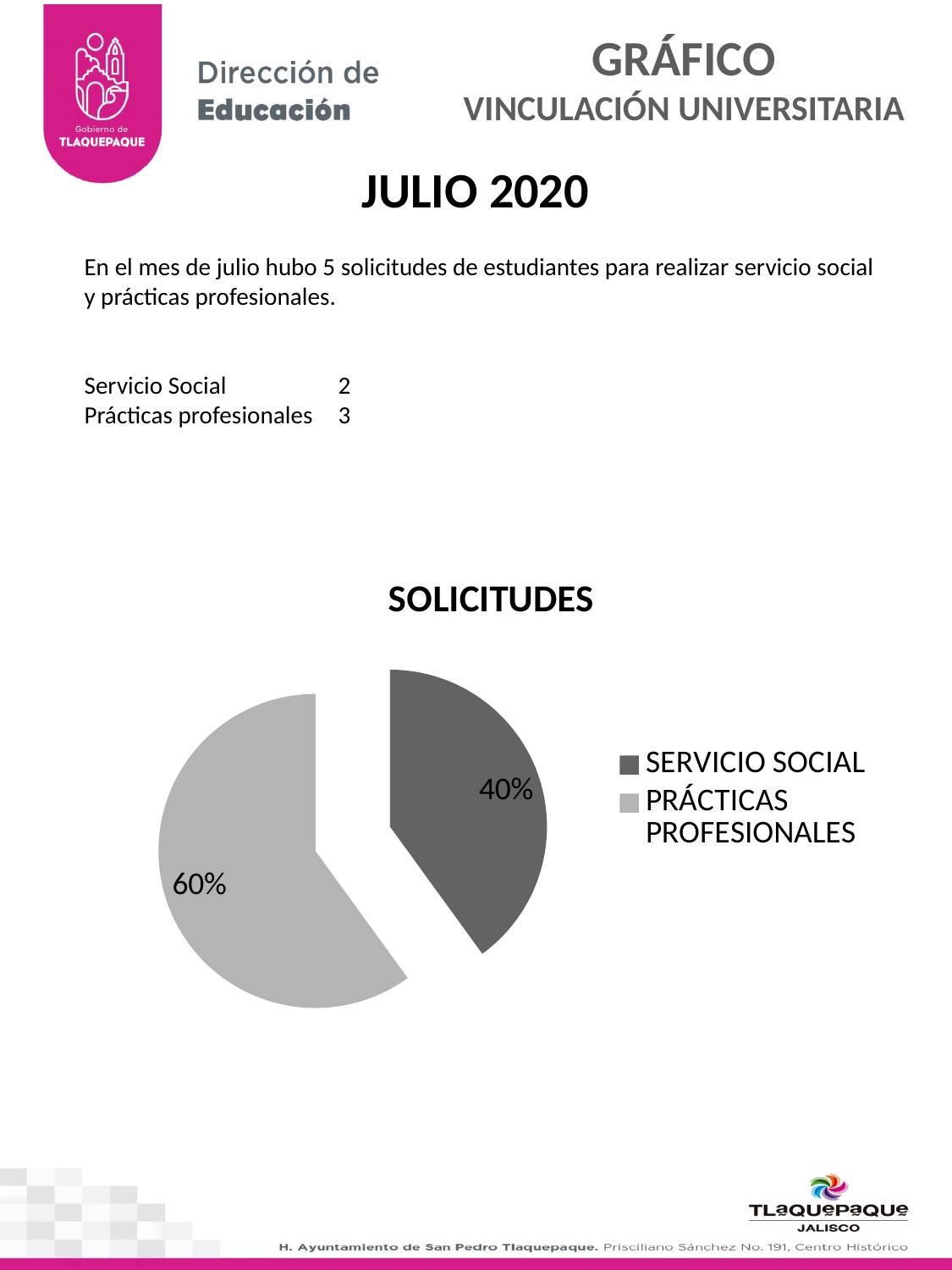
Which slice of the pie is the largest? PRÁCTICAS PROFESIONALES What share of the pie does SERVICIO SOCIAL represent? 40% Which is larger, the SERVICIO SOCIAL slice or the PRÁCTICAS PROFESIONALES slice? PRÁCTICAS PROFESIONALES Is the share for SERVICIO SOCIAL greater or less than 50%? less How many slices does the pie chart have? 2 What is the difference in percentage points between the PRÁCTICAS PROFESIONALES slice and the SERVICIO SOCIAL slice? 20% What share of the pie does PRÁCTICAS PROFESIONALES represent? 60% Which slice of the pie is the smallest? SERVICIO SOCIAL Which legend entry is shown in the lighter grey colour? PRÁCTICAS PROFESIONALES What kind of chart is shown under the title SOLICITUDES? pie chart How many entries does the legend list? 2 What is the title of the chart? SOLICITUDES